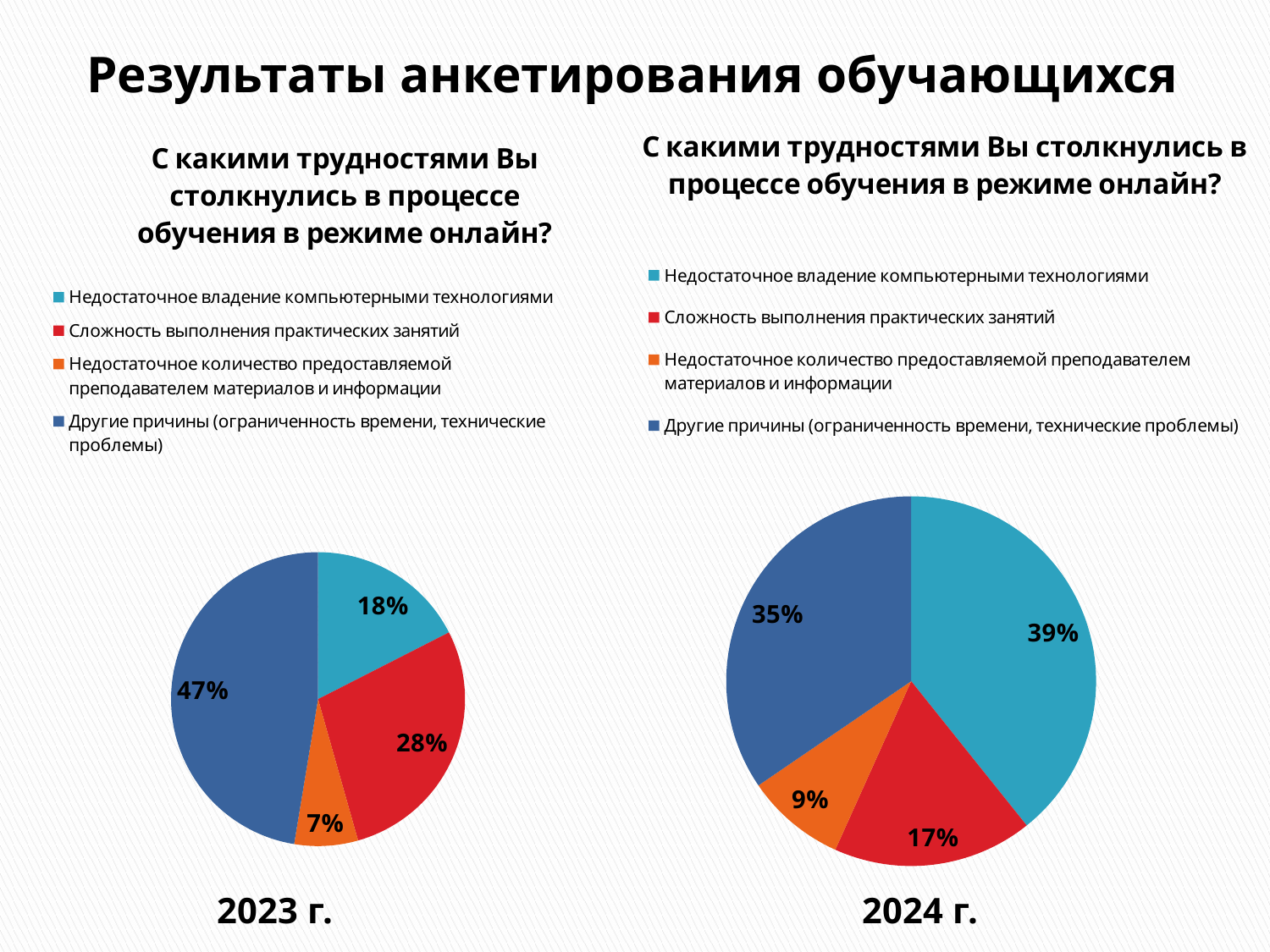
What is the difference between the share for «Недостаточное владение компьютерными технологиями» in the 2024 chart and in the 2023 chart? 21% In the 2023 pie chart, what share is labelled for «Недостаточное владение компьютерными технологиями»? 18% In the 2023 pie chart, what colour is the slice for «Сложность выполнения практических занятий»? Red In the 2023 pie chart, which category has the largest slice? Другие причины (ограниченность времени, технические проблемы) How many slices does the 2023 pie chart have? 4 What type of chart is used for the 2024 data? Pie chart In the 2024 pie chart, what share is labelled for «Сложность выполнения практических занятий»? 17% In the 2024 pie chart, which category has the largest slice? Недостаточное владение компьютерными технологиями Which is larger: the share for «Сложность выполнения практических занятий» in the 2023 chart or in the 2024 chart? 2023 In the 2024 pie chart, which category has the smallest slice? Недостаточное количество предоставляемой преподавателем материалов и информации In the 2024 pie chart, what share is labelled for «Другие причины (ограниченность времени, технические проблемы)»? 35% In the 2023 pie chart, what share is labelled for «Недостаточное количество предоставляемой преподавателем материалов и информации»? 7%